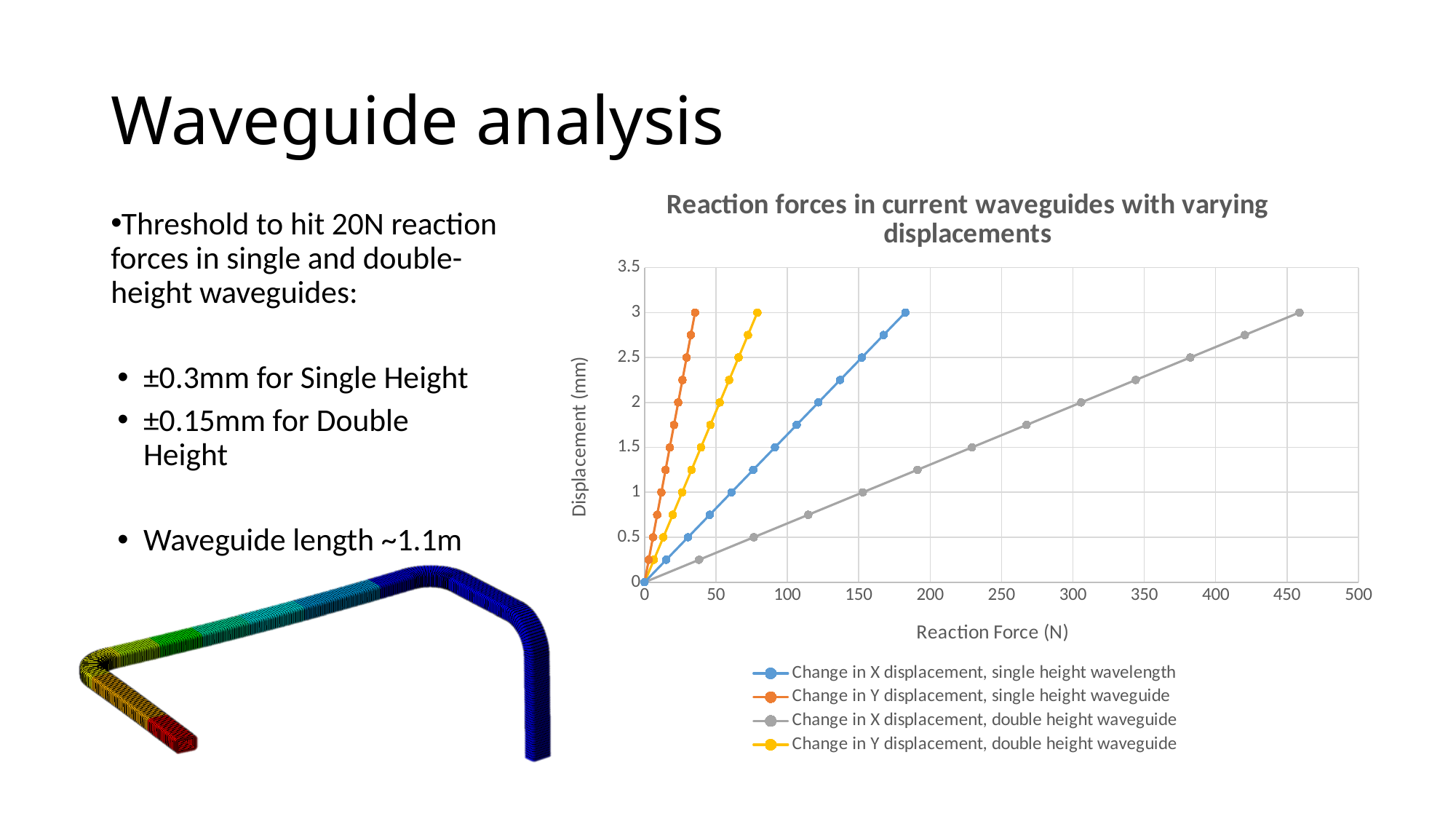
What is the title of the chart? Reaction forces in current waveguides with varying displacements What kind of chart is shown on the slide? Line chart Is the reaction force for 'Change in Y displacement, double height waveguide' at 3 mm displacement greater or less than 100? less Which series reaches the highest reaction force at 3 mm displacement? Change in X displacement, double height waveguide How many data points are plotted for the 'Change in X displacement, double height waveguide' series? 13 Which series reaches the lowest reaction force at 3 mm displacement? Change in Y displacement, single height waveguide Is the reaction force for 'Change in X displacement, double height waveguide' at 3 mm displacement greater or less than 400? greater Is the reaction force for 'Change in X displacement, single height wavelength' at 3 mm displacement greater or less than 200? less At 3 mm displacement, which series has the larger reaction force: 'Change in X displacement, single height wavelength' or 'Change in Y displacement, double height waveguide'? Change in X displacement, single height wavelength How many series does the legend list? 4 What is the label of the x axis? Reaction Force (N)